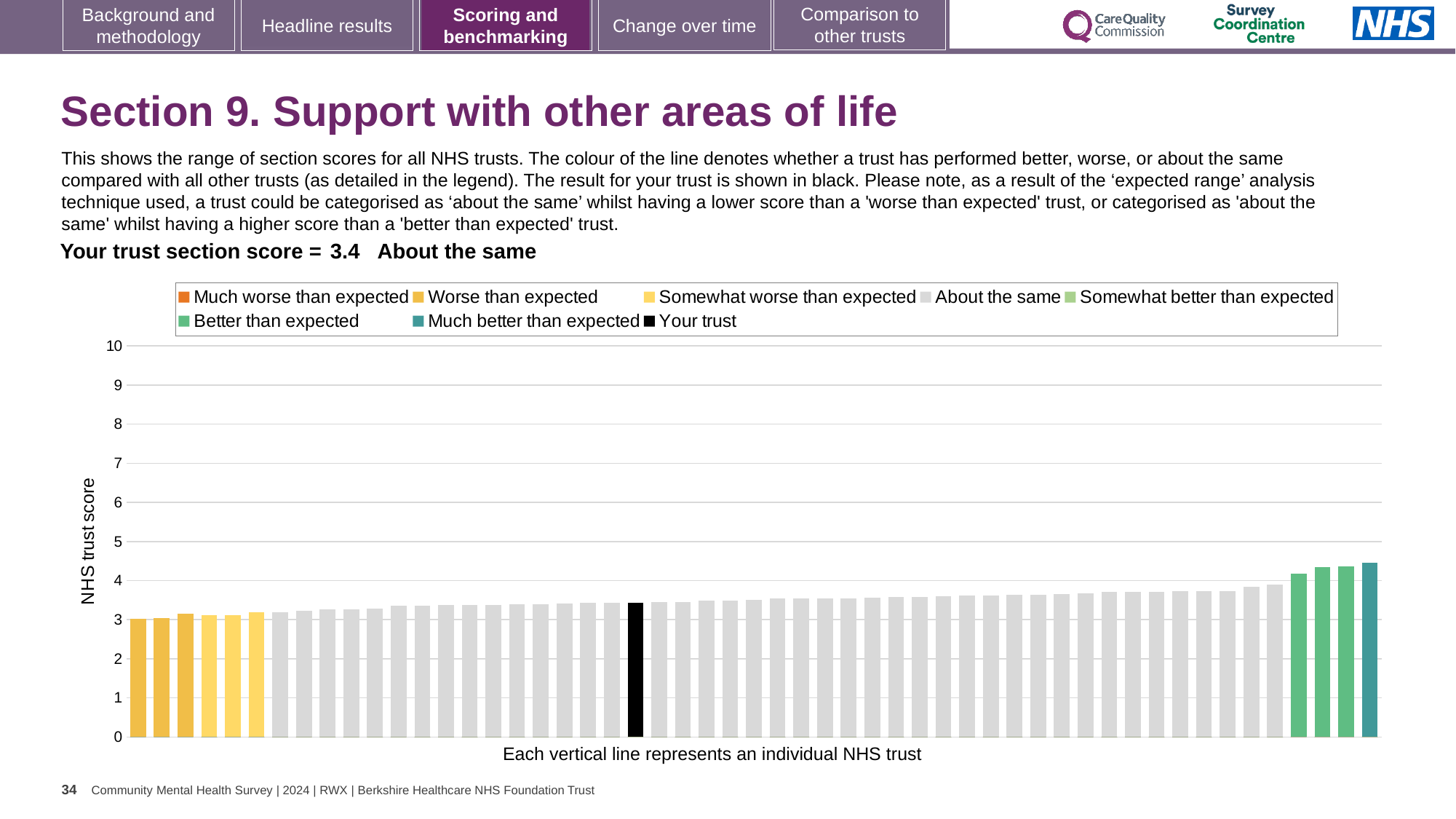
Which category is your trust placed in for this section? About the same Is the value of the highest bar greater or less than 5? less How many bars are coloured as 'Better than expected' (green)? 3 Is the value of the lowest bar on the chart greater or less than 2? greater Is the value of the black 'Your trust' bar greater or less than 4? less What is the label on the vertical axis of the chart? NHS trust score What is the section score for your trust shown on the slide? 3.4 How many entries does the chart legend list? 8 What kind of chart is shown on the slide? bar chart Do the bar values rise or fall from left to right along the x axis? rise Which legend category does the tallest bar on the chart belong to? Much better than expected